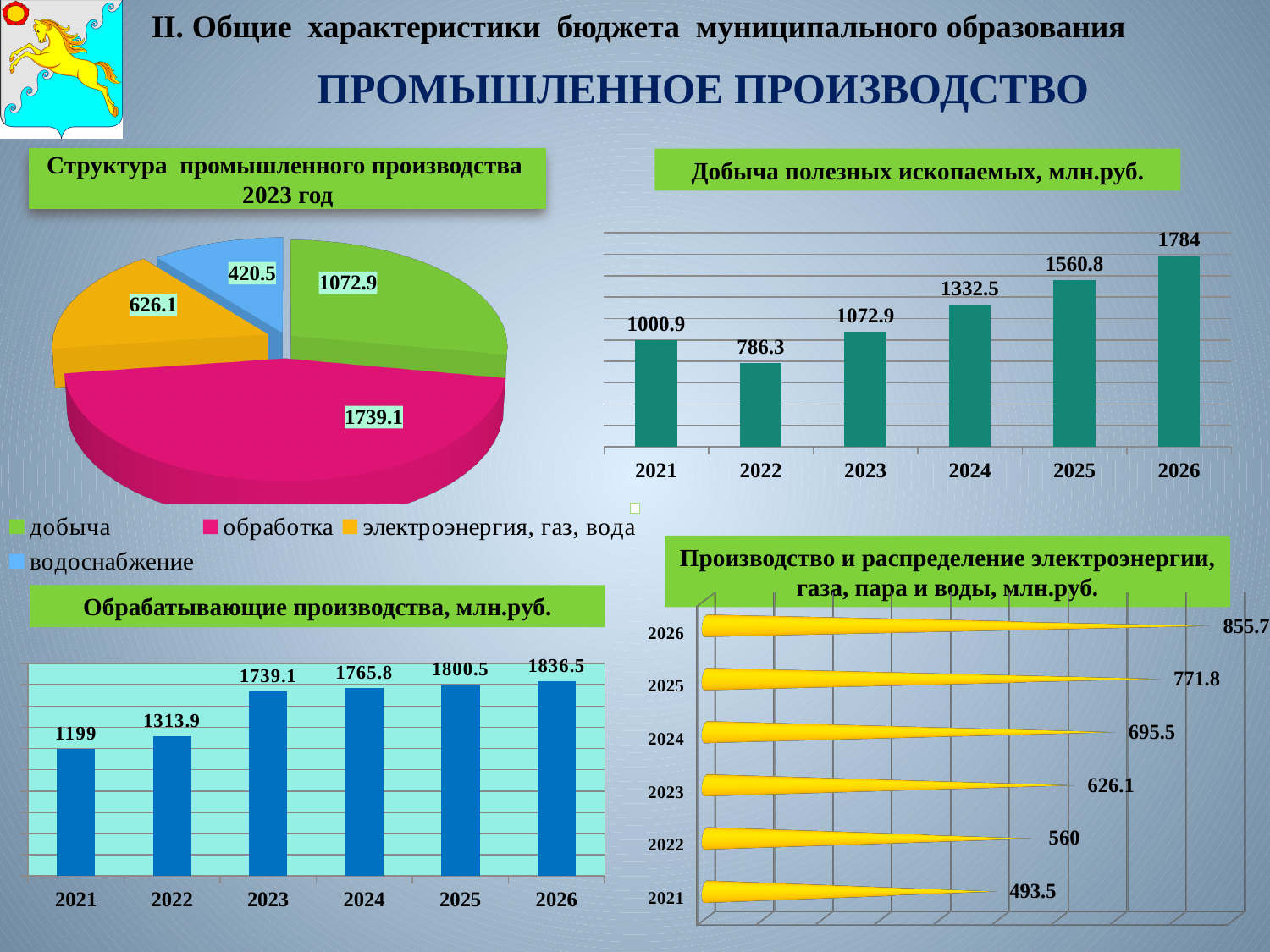
In the chart 'Производство и распределение электроэнергии, газа, пара и воды, млн.руб.', what is the difference between the values for 2026 and 2021? 362.2 In the chart 'Добыча полезных ископаемых, млн.руб.', which is larger, the value for 2021 or the value for 2022? 2021 In the pie chart 'Структура промышленного производства 2023 год', what is the value for обработка? 1739.1 In the chart 'Добыча полезных ископаемых, млн.руб.', which year has the lowest value? 2022 In the chart 'Производство и распределение электроэнергии, газа, пара и воды, млн.руб.', what is the value for 2025? 771.8 In the pie chart 'Структура промышленного производства 2023 год', which category has the smallest value? водоснабжение In the chart 'Добыча полезных ископаемых, млн.руб.', what is the value for 2024? 1332.5 How many categories does the legend of the pie chart 'Структура промышленного производства 2023 год' list? 4 What kind of chart is 'Обрабатывающие производства, млн.руб.'? bar chart In the chart 'Обрабатывающие производства, млн.руб.', what is the value for 2022? 1313.9 In the chart 'Добыча полезных ископаемых, млн.руб.', what is the difference between the values for 2026 and 2025? 223.2 In the chart 'Обрабатывающие производства, млн.руб.', do the values rise or fall from 2021 to 2026? rise